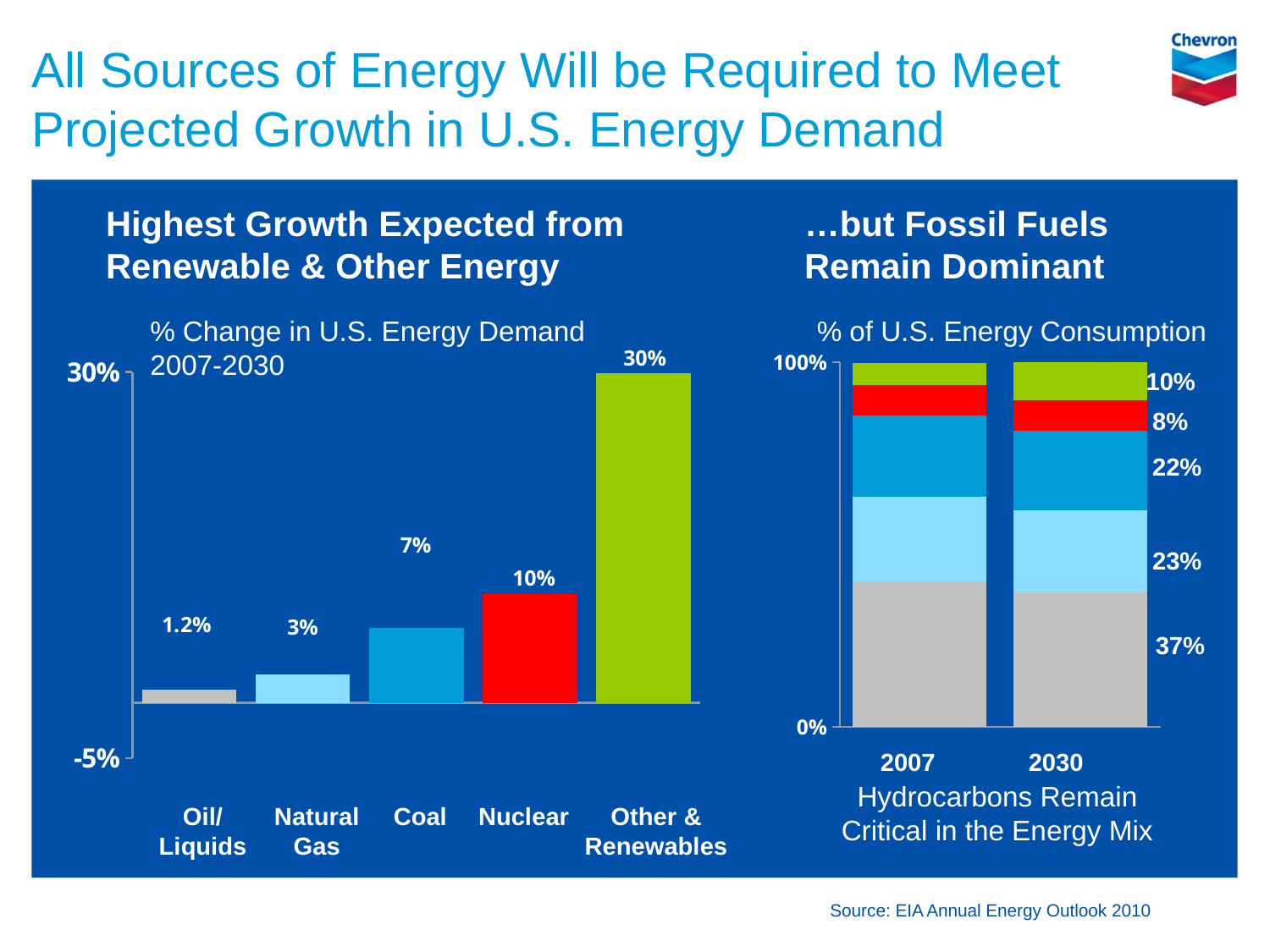
In the '% of U.S. Energy Consumption' chart, what is the value of the largest segment of the 2030 bar? 37% What kind of chart is the '% Change in U.S. Energy Demand 2007-2030' chart? Bar chart In the '% Change in U.S. Energy Demand 2007-2030' chart, which is larger, the value for Coal or the value for Nuclear? Nuclear How many categories are shown in the '% Change in U.S. Energy Demand 2007-2030' chart? 5 In the '% Change in U.S. Energy Demand 2007-2030' chart, what is the value for Oil/Liquids? 1.2% In the '% Change in U.S. Energy Demand 2007-2030' chart, what is the value for Coal? 7% How many bars are shown in the '% of U.S. Energy Consumption' chart? 2 In the '% of U.S. Energy Consumption' chart, what is the total of the labelled segments in the 2030 bar? 100% In the '% Change in U.S. Energy Demand 2007-2030' chart, do the values rise or fall from left to right across the categories? Rise In the '% Change in U.S. Energy Demand 2007-2030' chart, which category has the highest value? Other & Renewables In the '% Change in U.S. Energy Demand 2007-2030' chart, which category has the lowest value? Oil/Liquids In the '% Change in U.S. Energy Demand 2007-2030' chart, what is the difference between the values for Nuclear and Natural Gas? 7%